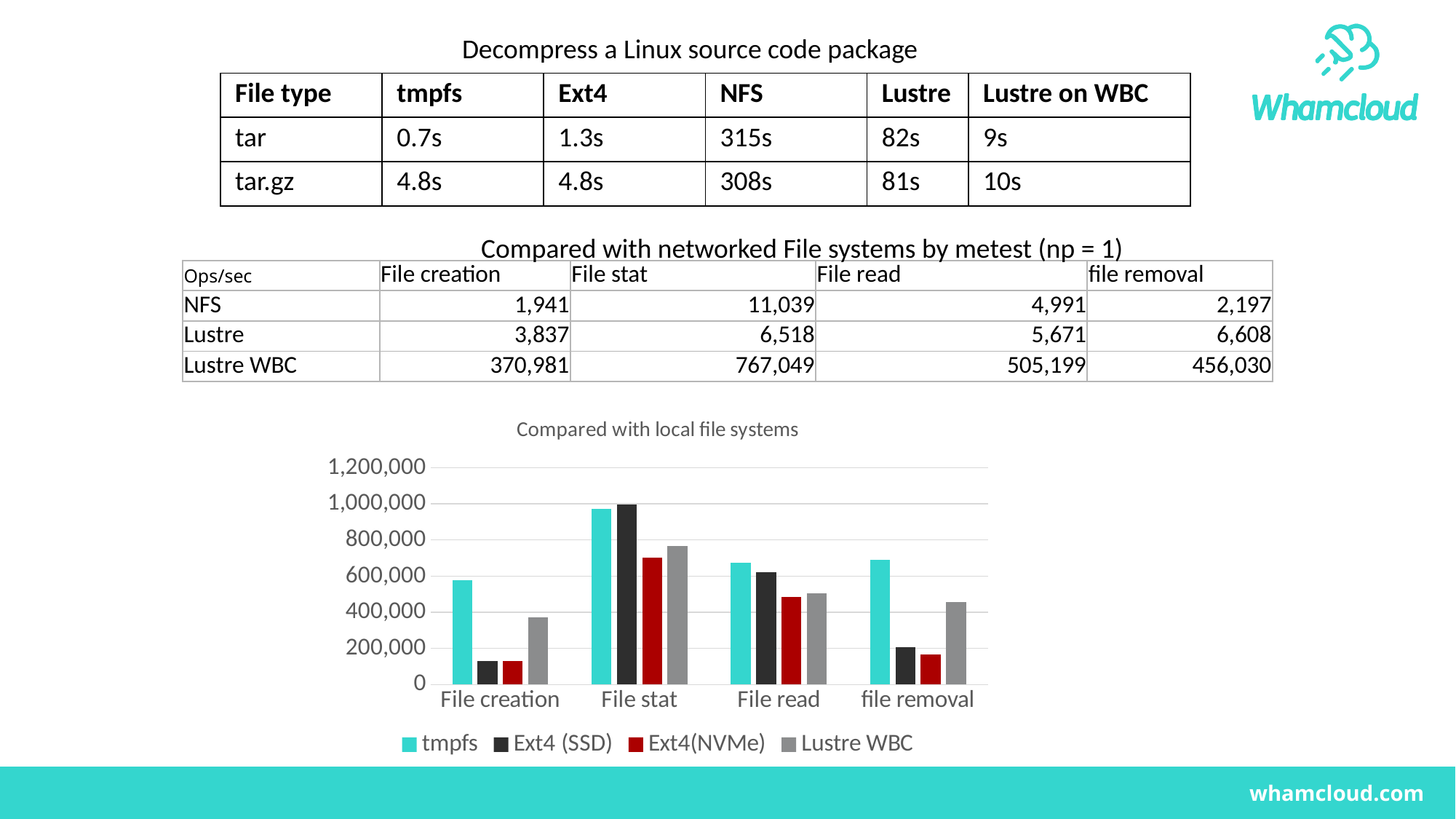
In the "Compared with local file systems" chart, which series has the lowest value for File stat? Ext4(NVMe) How many series does the legend of the "Compared with local file systems" chart list? 4 What kind of chart is "Compared with local file systems"? bar chart In the "Compared with local file systems" chart, which is larger for File creation: tmpfs or Lustre WBC? tmpfs In the "Compared with local file systems" chart, which category has the highest tmpfs value? File stat How many categories are shown on the x axis of the "Compared with local file systems" chart? 4 In the "Compared with local file systems" chart, which series has the highest value for file removal? tmpfs In the "Compared with local file systems" chart, which is larger for File read: Ext4 (SSD) or Ext4(NVMe)? Ext4 (SSD) In the "Compared with local file systems" chart, is the tmpfs value for File creation greater or less than 400,000? greater In the "Compared with local file systems" chart, which category has the lowest Ext4 (SSD) value? File creation In the "Compared with local file systems" chart, is the Ext4(NVMe) value for File creation greater or less than 200,000? less What is the title of the bar chart on the slide? Compared with local file systems